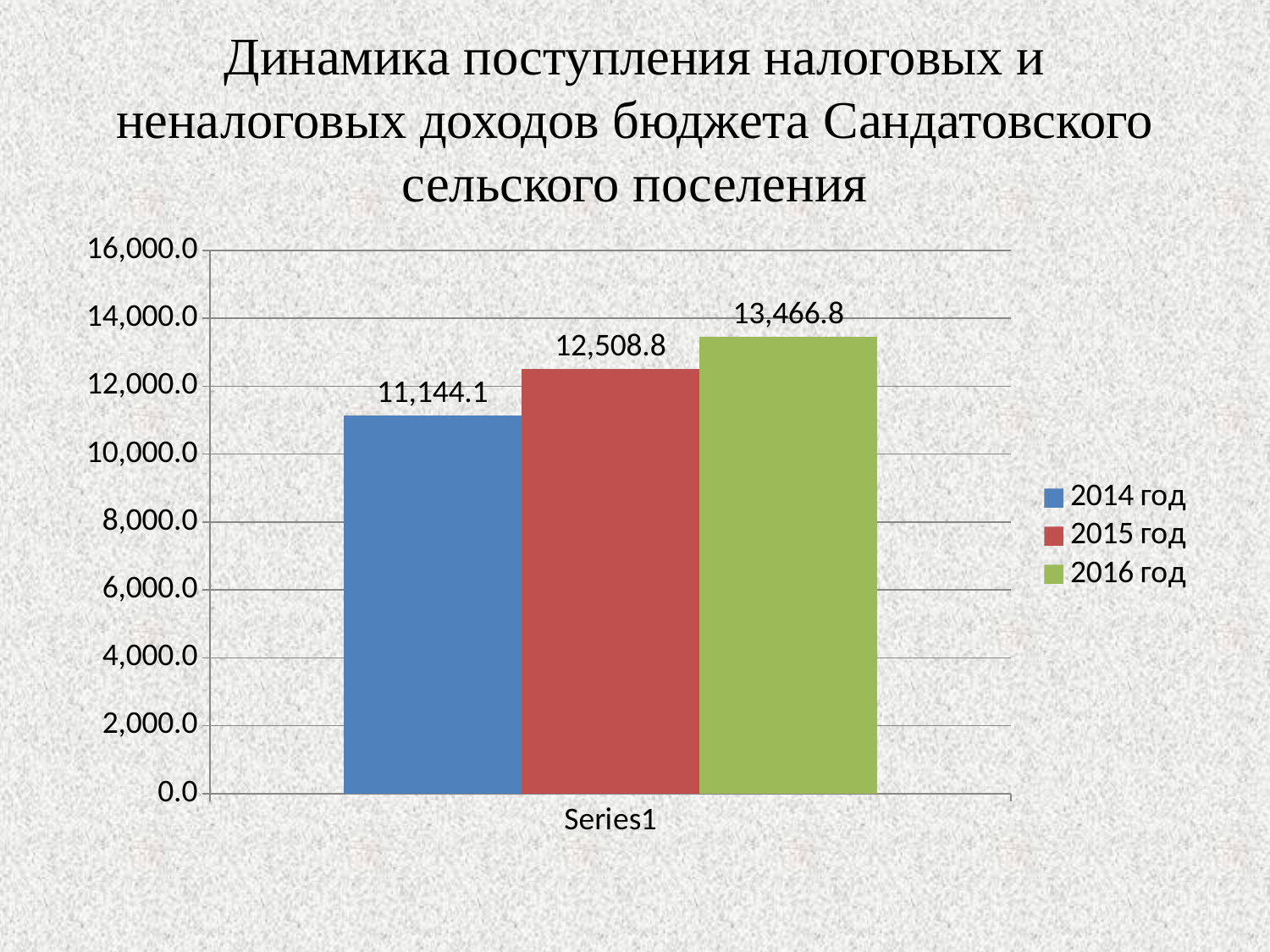
What kind of chart is shown on the slide? bar chart Which year has the highest value? 2016 год What is the difference between the values for 2016 год and 2015 год? 958.0 Which year has the lowest value? 2014 год Do the values rise or fall from 2014 год to 2016 год? rise How many series does the legend list? 3 What is the value for 2016 год? 13,466.8 Which is larger, the value for 2014 год or the value for 2016 год? 2016 год Is the value for 2014 год greater or less than 12,000.0? less What is the value for 2015 год? 12,508.8 What is the difference between the values for 2015 год and 2014 год? 1,364.7 What is the value for 2014 год? 11,144.1